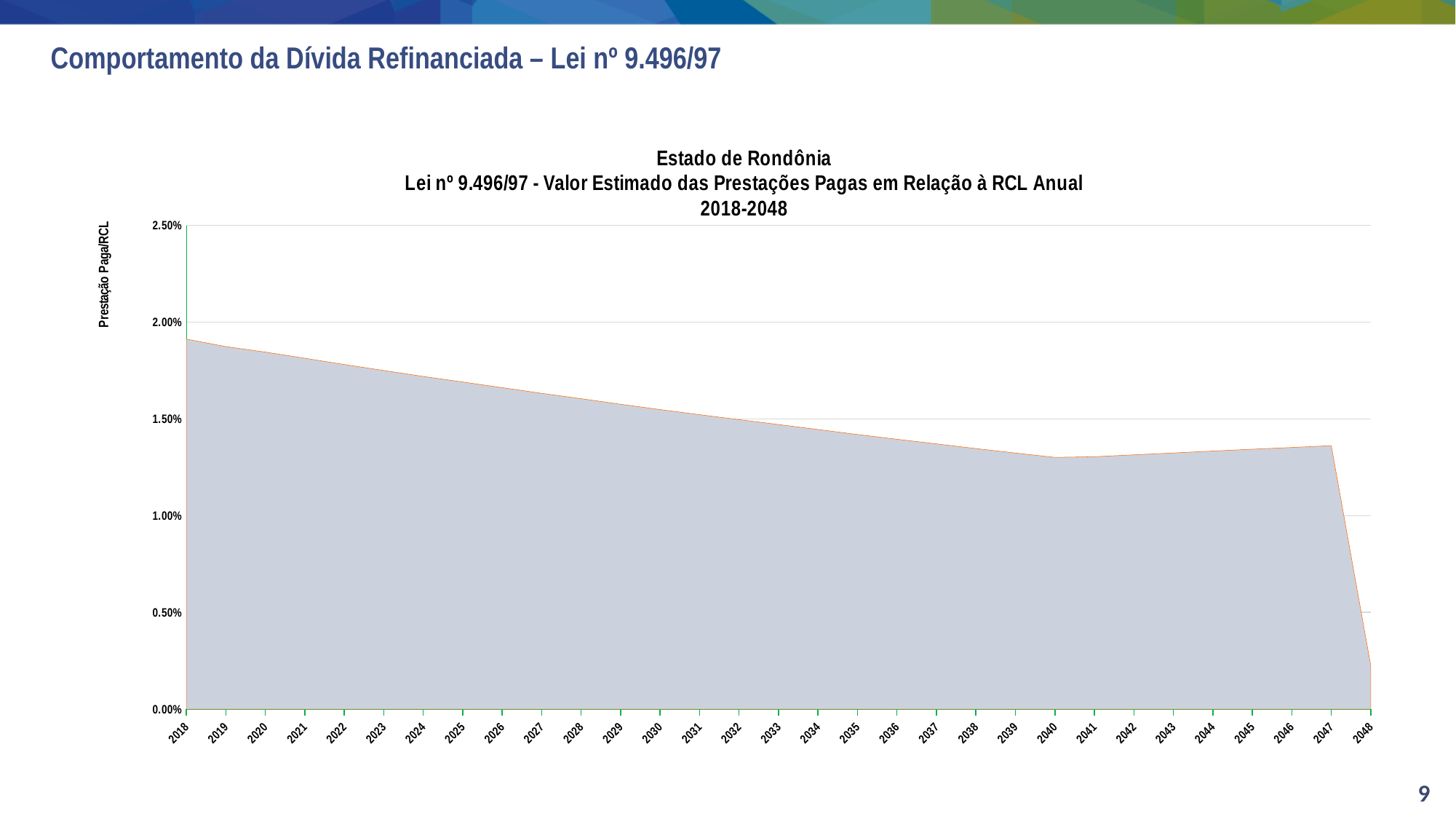
How many years are plotted along the x axis of the chart? 31 Is the value for 2030 greater or less than 1.00%? greater What is the label of the vertical axis? Prestação Paga/RCL Which year has the larger value, 2020 or 2035? 2020 What kind of chart is shown on the slide? Area chart Which year has the highest value in the chart? 2018 Is the value for 2040 greater or less than 1.50%? less Do the values rise or fall from 2018 to 2040? fall Is the value for 2048 greater or less than 0.50%? less What range of years does the chart title say it covers? 2018-2048 Which year has the lowest value in the chart? 2048